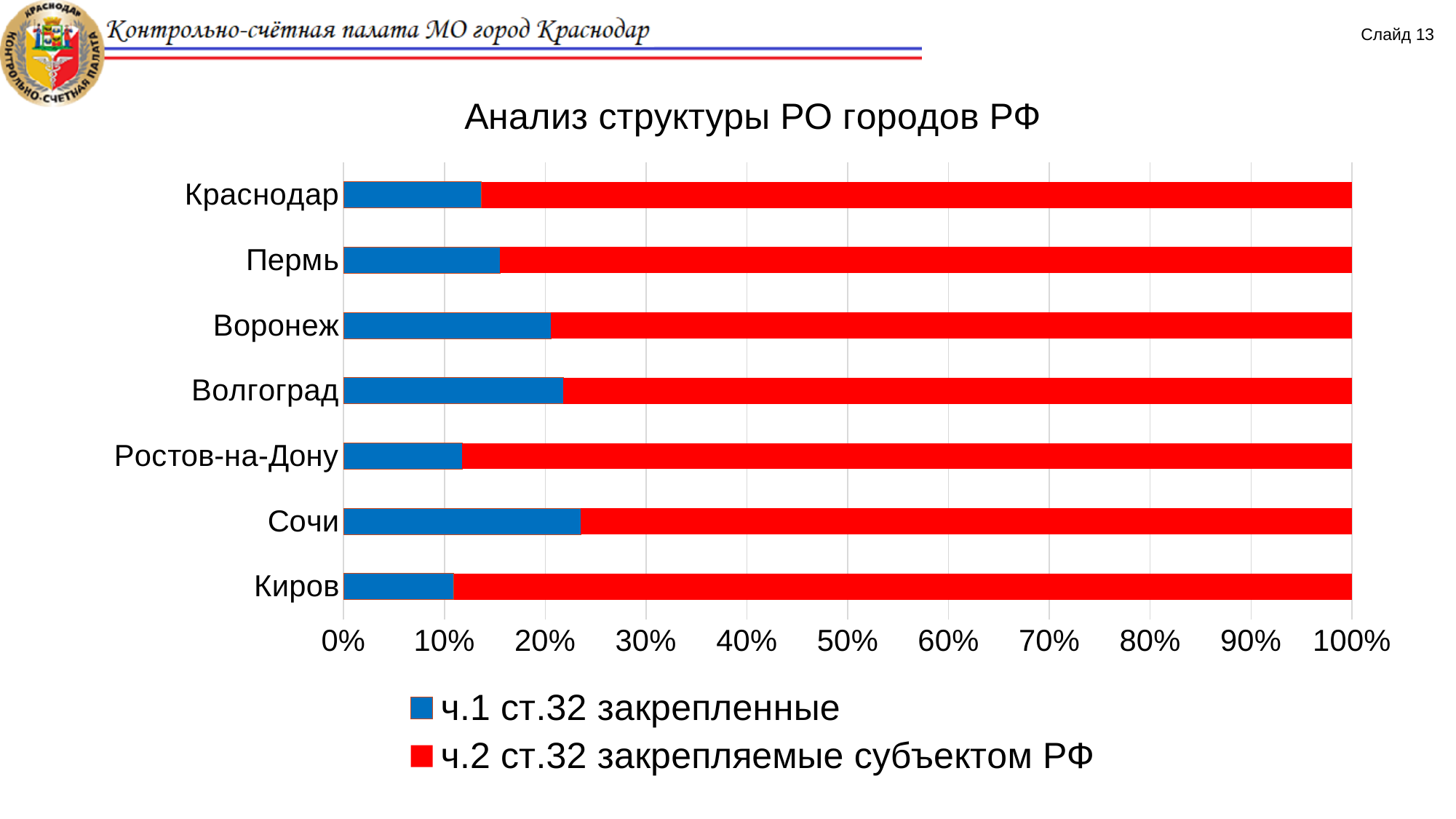
Is the "ч.1 ст.32 закрепленные" share for Киров greater or less than 20%? less What kind of chart is shown on the slide? Stacked bar chart Is the "ч.1 ст.32 закрепленные" share for Краснодар greater or less than 20%? less Which city has the largest share for "ч.1 ст.32 закрепленные"? Сочи Which colour represents the series "ч.2 ст.32 закрепляемые субъектом РФ"? Red Is the "ч.1 ст.32 закрепленные" share for Сочи greater or less than 20%? greater Which city has a larger "ч.1 ст.32 закрепленные" share, Сочи or Киров? Сочи How many cities are listed on the chart? 7 What is the title of the chart? Анализ структуры РО городов РФ How many series does the legend list? 2 Which city has a larger "ч.1 ст.32 закрепленные" share, Волгоград or Краснодар? Волгоград